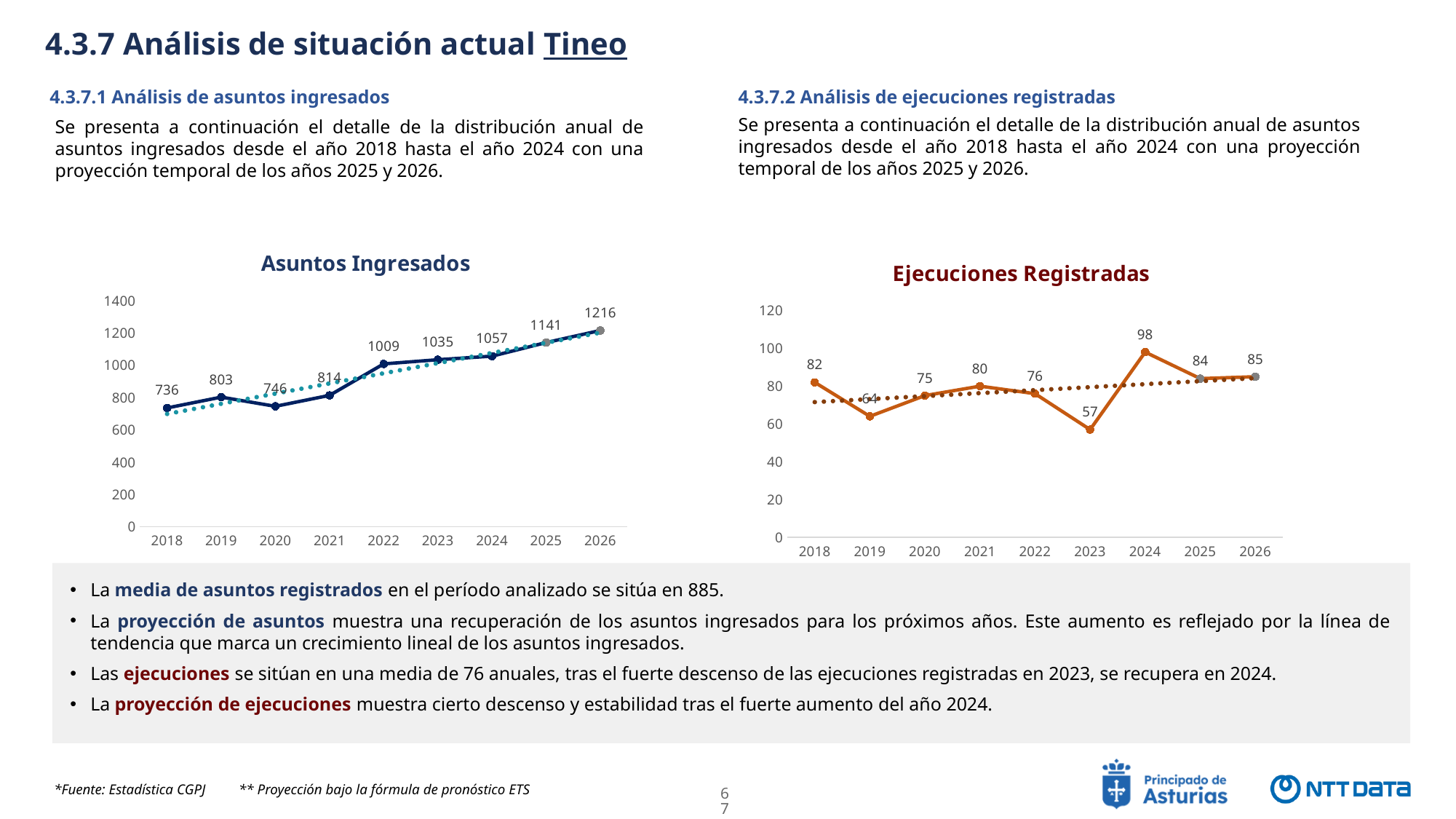
What kind of chart is 'Ejecuciones Registradas'? Line chart In the 'Asuntos Ingresados' chart, what is the difference between the values for 2024 and 2018? 321 In the 'Ejecuciones Registradas' chart, what is the difference between the values for 2024 and 2023? 41 In the 'Ejecuciones Registradas' chart, which year has the lowest value? 2023 In the 'Ejecuciones Registradas' chart, what is the value for 2023? 57 In the 'Asuntos Ingresados' chart, how many years are shown on the x axis? 9 In the 'Asuntos Ingresados' chart, what is the value for 2022? 1009 In the 'Asuntos Ingresados' chart, what is the projected value for 2026? 1216 In the 'Asuntos Ingresados' chart, which year has the lowest value? 2018 In the 'Ejecuciones Registradas' chart, which year has the highest value? 2024 In the 'Ejecuciones Registradas' chart, which is larger, the value for 2018 or the value for 2019? 2018 In the 'Asuntos Ingresados' chart, do the values generally rise or fall from 2021 to 2026? Rise